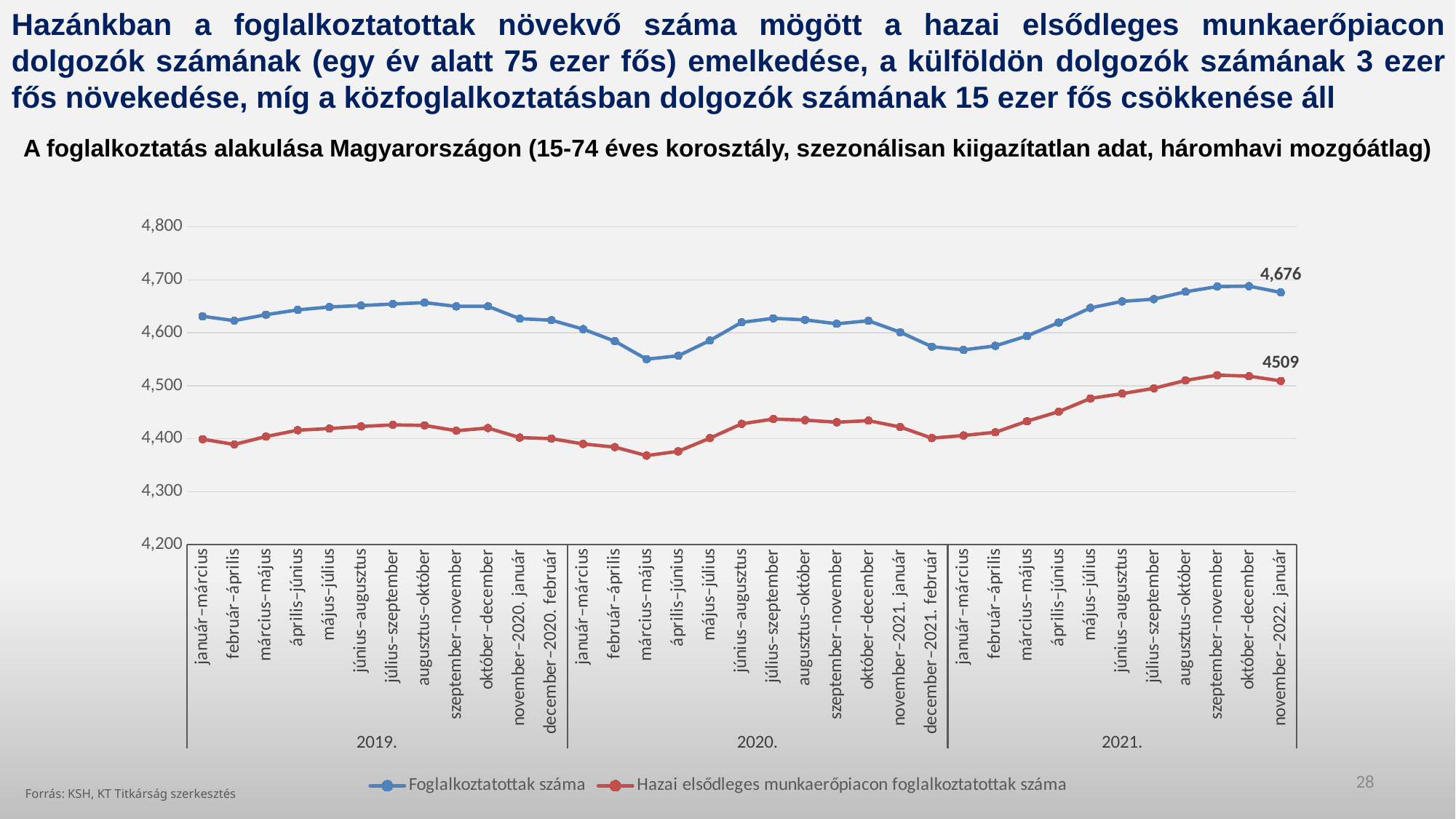
What is the value of Foglalkoztatottak száma for november–2022. január? 4,676 What is the difference between the two labelled values for november–2022. január (4,676 and 4509)? 167 Is the value of Foglalkoztatottak száma for március–május 2020 greater or less than 4,600? less How many years are labelled along the x axis? 3 Which series has the higher value for november–2022. január? Foglalkoztatottak száma What colour is the line for Foglalkoztatottak száma? blue Is the value of Foglalkoztatottak száma for augusztus–október 2019 greater or less than 4,600? greater Between március–május 2021 and szeptember–november 2021, does Foglalkoztatottak száma rise or fall? rise Is the value of Hazai elsődleges munkaerőpiacon foglalkoztatottak száma for március–május 2020 greater or less than 4,400? less What is the value of Hazai elsődleges munkaerőpiacon foglalkoztatottak száma for november–2022. január? 4509 What kind of chart is shown on the slide? line chart How many series does the legend list? 2